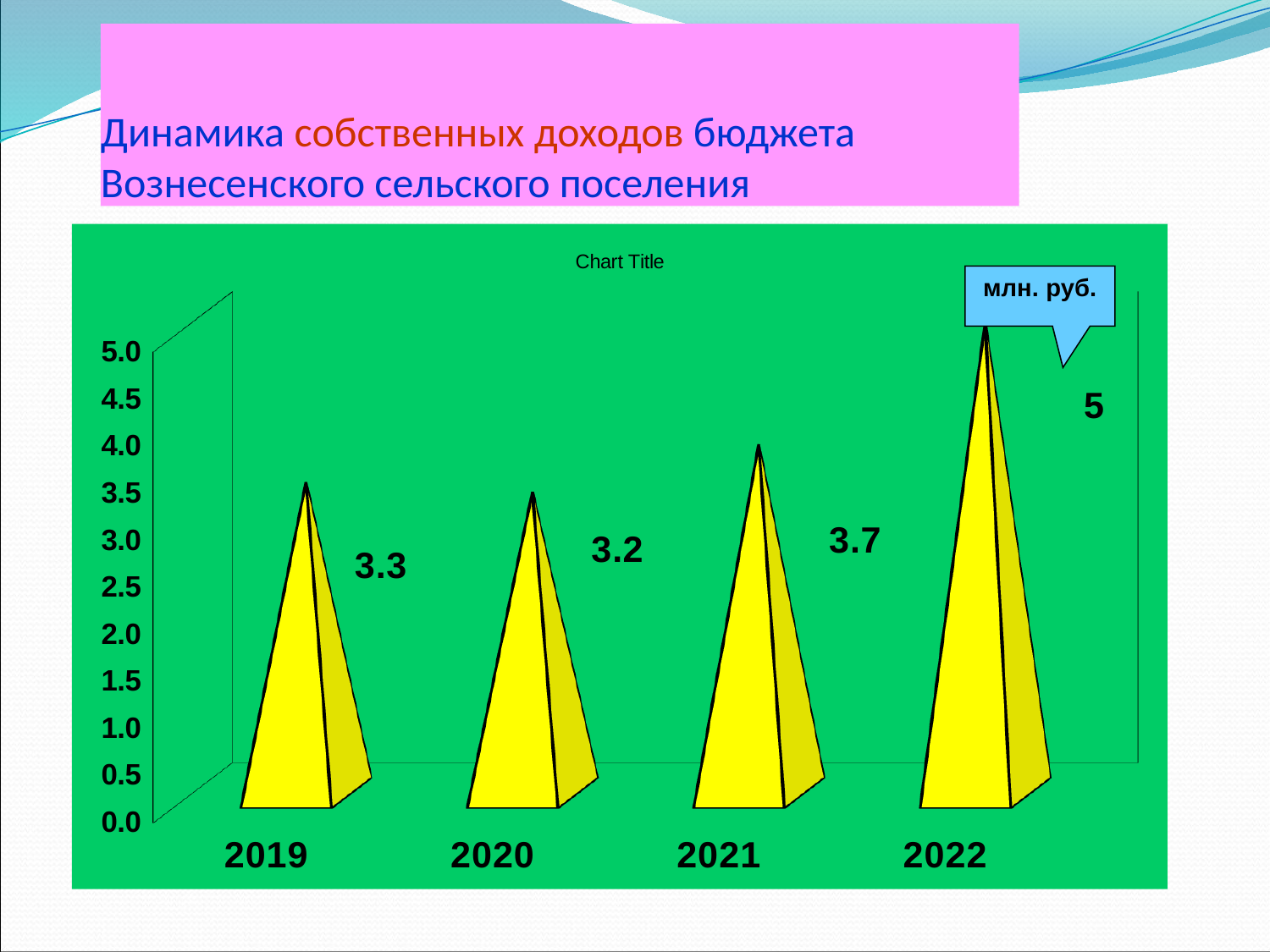
What is the value for 2021? 3.7 What is the difference between the values for 2022 and 2021? 1.3 How many years are shown on the x axis? 4 What is the value for 2019? 3.3 What is the value for 2022? 5 What kind of chart is shown on the slide? bar chart Which year has the lowest value? 2020 Which is larger, the value for 2019 or the value for 2020? 2019 What unit is shown in the callout on the chart? млн. руб. Which year has the highest value? 2022 What is the value for 2020? 3.2 Is the value for 2021 greater or less than 3.5? greater